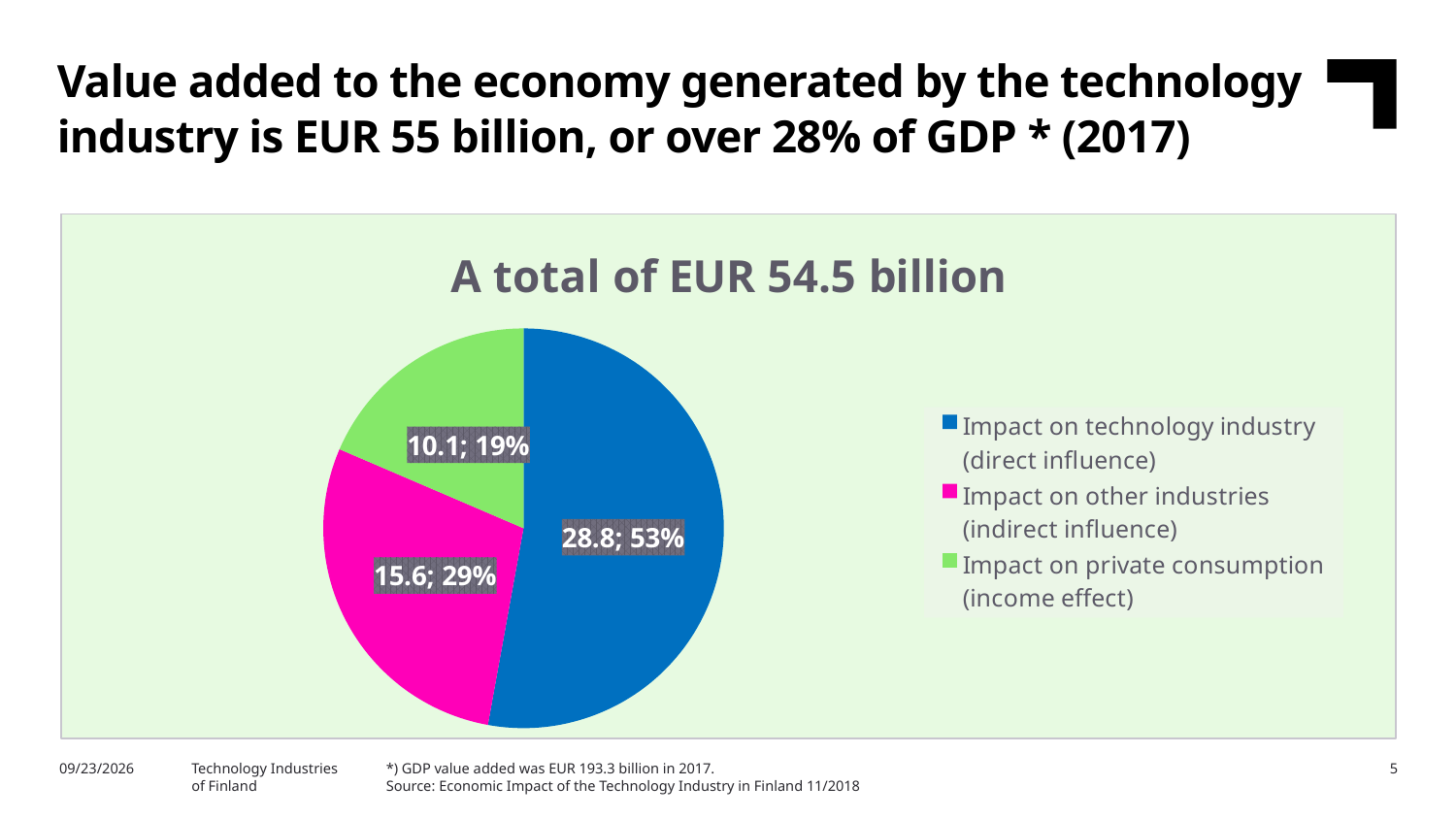
What is the value for Impact on private consumption (income effect)? 10.1 Which category has the smallest slice of the pie? Impact on private consumption (income effect) What type of chart is shown on the slide? pie chart What is the value for Impact on other industries (indirect influence)? 15.6 What share of the pie does Impact on private consumption (income effect) represent? 19% What is the value for Impact on technology industry (direct influence)? 28.8 What is the title of the chart? A total of EUR 54.5 billion Which category has the largest slice of the pie? Impact on technology industry (direct influence) What is the difference between the values for Impact on technology industry (direct influence) and Impact on other industries (indirect influence)? 13.2 How many slices does the pie chart have? 3 Which is larger: Impact on other industries (indirect influence) or Impact on private consumption (income effect)? Impact on other industries (indirect influence) What share of the pie does Impact on technology industry (direct influence) represent? 53%